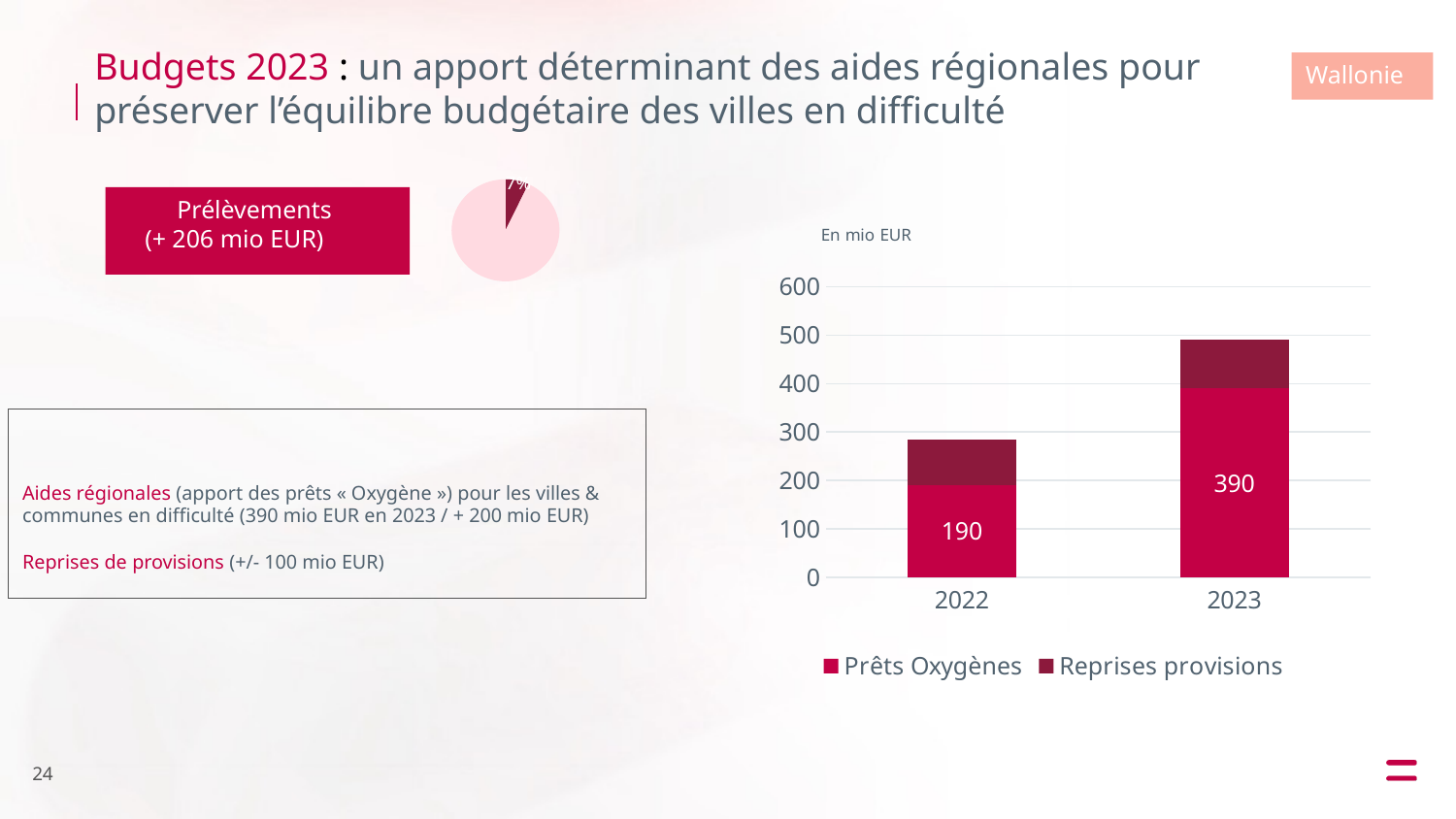
How many years (categories) are shown on the x axis of the bar chart? 2 What kind of chart is the chart on the right of the slide? Stacked bar chart In the bar chart, is the total stacked value for 2022 greater or less than 400? less What unit label is shown above the bar chart? En mio EUR In the bar chart, which year has the highest total stacked bar? 2023 In the bar chart, what is the difference between the Prêts Oxygènes values for 2023 and 2022? 200 In the bar chart, what is the value of Prêts Oxygènes for 2022? 190 In the bar chart, what is the value of Prêts Oxygènes for 2023? 390 How many series does the legend of the bar chart list? 2 In the bar chart, which year has the larger Prêts Oxygènes value, 2022 or 2023? 2023 In the bar chart, do the Prêts Oxygènes values rise or fall from 2022 to 2023? Rise In the bar chart, is the total stacked value for 2023 greater or less than 400? greater